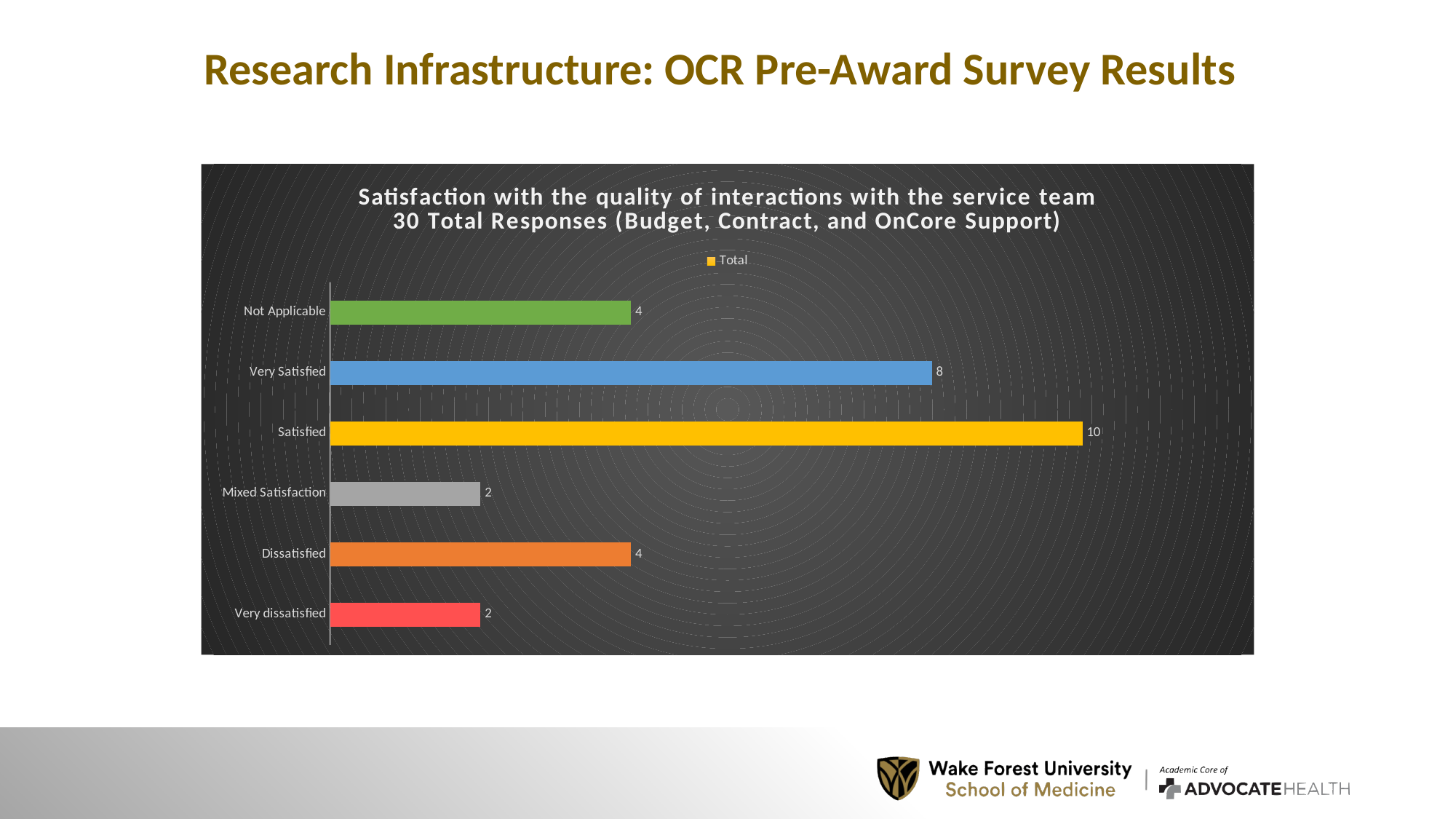
How many categories are shown in the chart? 6 Which is larger, the value for Dissatisfied or the value for Very dissatisfied? Dissatisfied What kind of chart is shown on the slide? Bar chart What is the value for Satisfied? 10 What is the difference between the values for Satisfied and Very Satisfied? 2 How many series does the legend list? 1 What is the value for Very Satisfied? 8 Which category has the highest value? Satisfied What is the name of the series listed in the legend? Total What is the value for Not Applicable? 4 What is the value for Mixed Satisfaction? 2 What is the difference between the values for Very Satisfied and Dissatisfied? 4